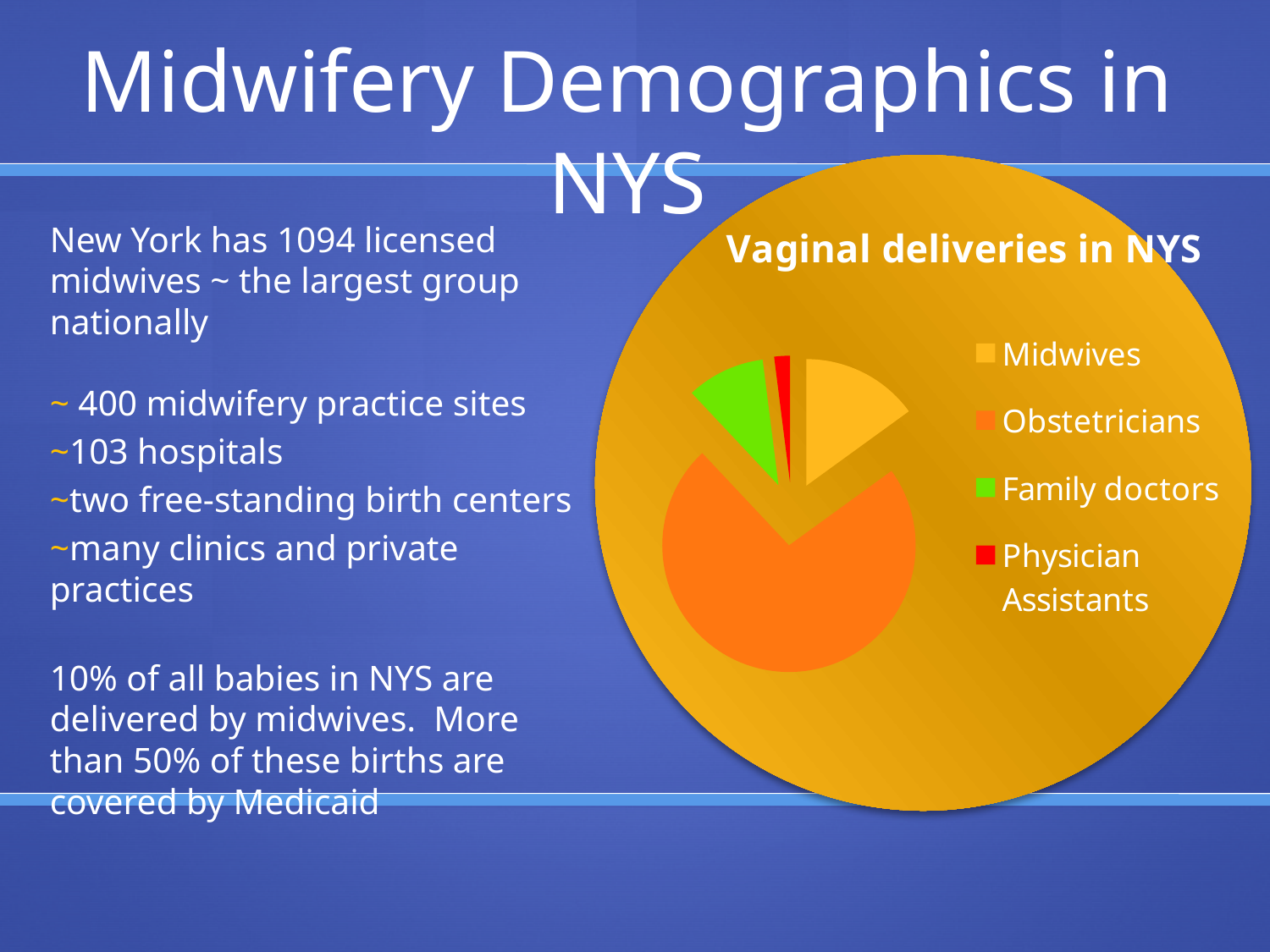
How many categories does the pie chart show? 4 In the pie chart, which slice is larger: Midwives or Family doctors? Midwives What is the title of the pie chart? Vaginal deliveries in NYS In the pie chart, which slice is larger: Midwives or Obstetricians? Obstetricians Which colour represents Obstetricians in the pie chart? Orange Which category has the largest slice in the pie chart? Obstetricians How many entries does the legend of the pie chart list? 4 Which category has the smallest slice in the pie chart? Physician Assistants What kind of chart is shown on the slide? Pie chart In the pie chart, which slice is larger: Family doctors or Physician Assistants? Family doctors Which category in the pie chart is shown in green? Family doctors